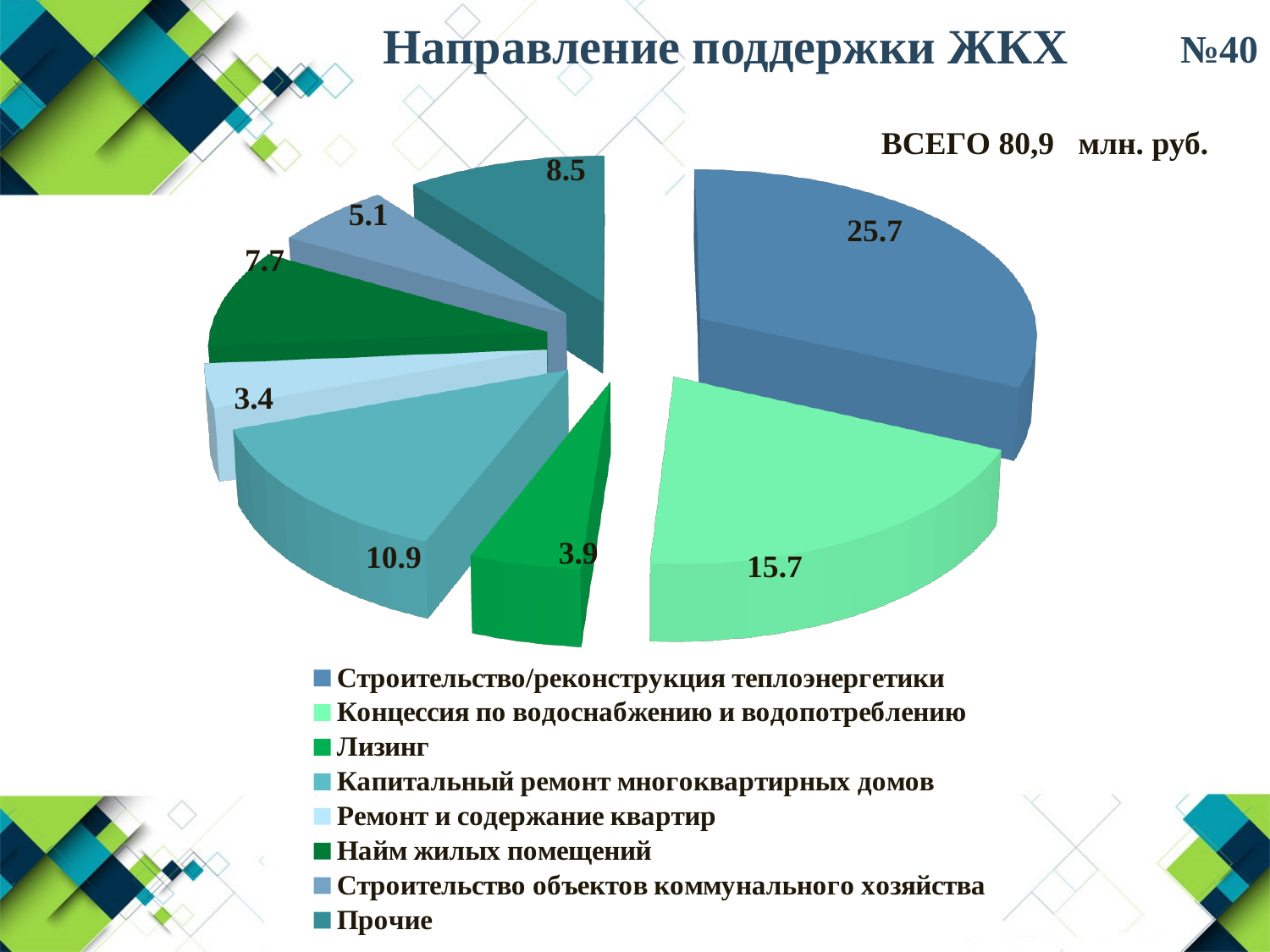
What is the difference between the values for Строительство/реконструкция теплоэнергетики and Концессия по водоснабжению и водопотреблению? 10.0 How many categories does the pie chart have? 8 What total amount is stated on the slide for all categories? 80,9 млн. руб. Which category has the largest slice of the pie? Строительство/реконструкция теплоэнергетики Which is larger: the value for Лизинг or the value for Строительство объектов коммунального хозяйства? Строительство объектов коммунального хозяйства What is the value for Найм жилых помещений? 7.7 Which category has the smallest slice of the pie? Ремонт и содержание квартир What is the value for Капитальный ремонт многоквартирных домов? 10.9 What is the difference between the values for Прочие and Строительство объектов коммунального хозяйства? 3.4 What kind of chart is shown on the slide? pie chart What is the value for Строительство/реконструкция теплоэнергетики? 25.7 What is the value for Прочие? 8.5